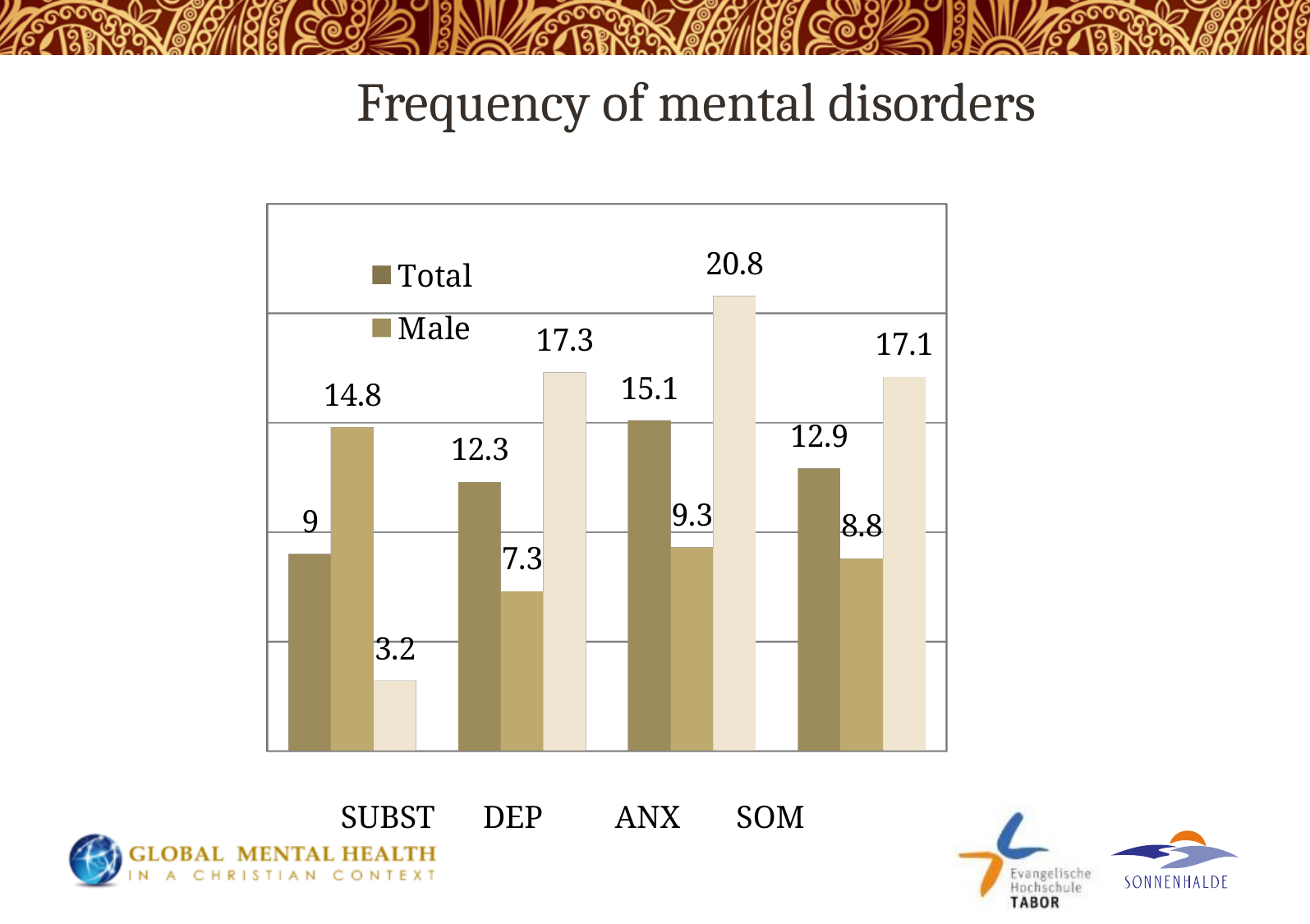
What is the difference between the Male values for SUBST and DEP? 7.5 Which category has the lowest Male value? DEP How many series does the chart's legend list? 2 What is the Male value for SUBST? 14.8 What is the difference between the Total values for ANX and SUBST? 6.1 How many categories are shown on the x axis of the chart? 4 What is the Total value for ANX? 15.1 What kind of chart is shown on the slide? bar chart What is the Male value for SOM? 8.8 For SUBST, which is larger: the Total value or the Male value? Male Which category has the highest Total value? ANX What is the title of the chart? Frequency of mental disorders